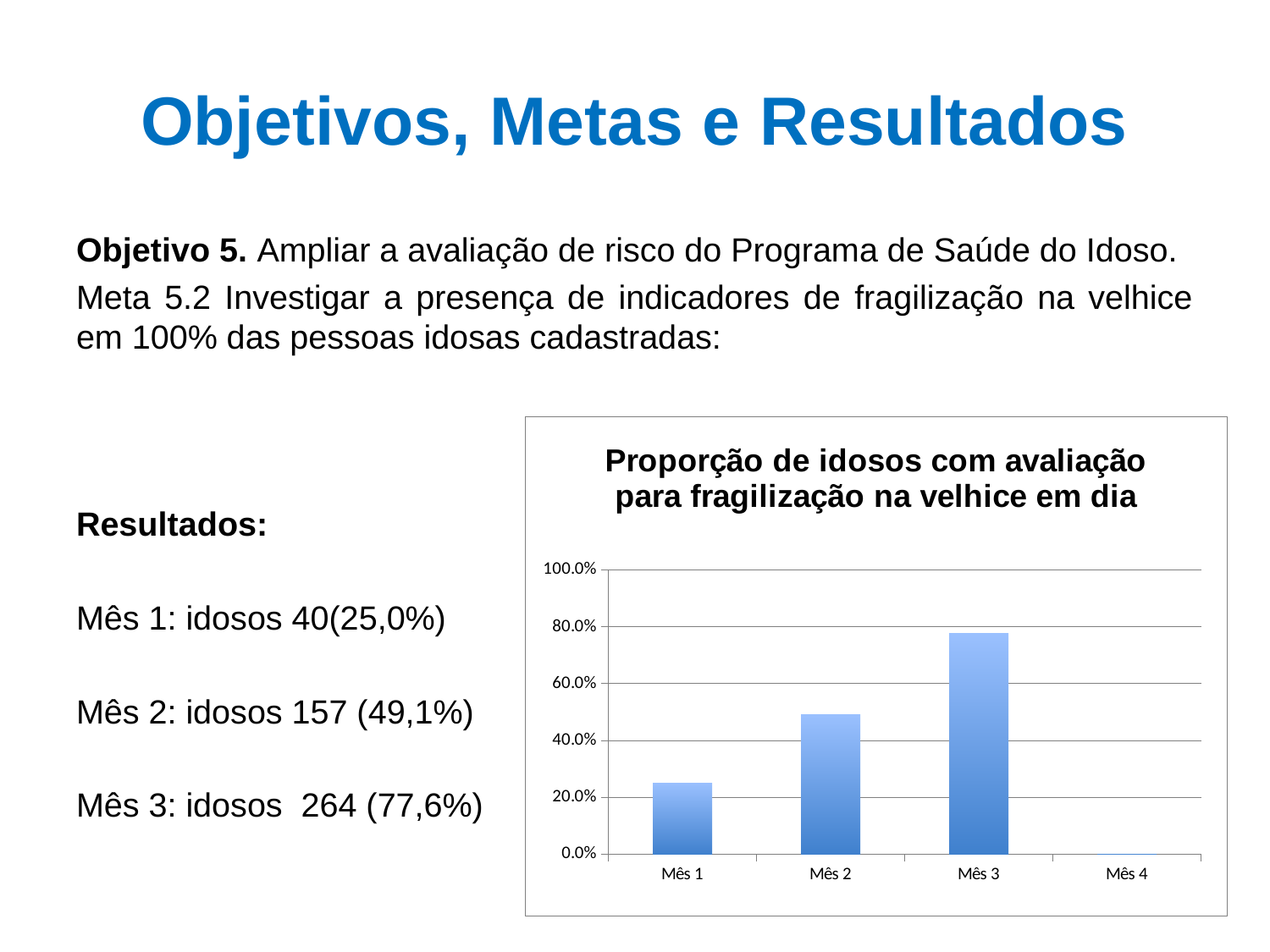
What is the title of the chart? Proporção de idosos com avaliação para fragilização na velhice em dia Is the value for Mês 3 greater or less than 60.0%? greater Which month has the highest bar in the chart? Mês 3 Which is larger, the value for Mês 2 or the value for Mês 3? Mês 3 What kind of chart is shown on the slide? bar chart Do the values rise or fall from Mês 1 to Mês 3? rise Among Mês 1, Mês 2 and Mês 3, which month has the lowest value in the chart? Mês 1 Is the value for Mês 3 greater or less than 80.0%? less How many categories are shown on the x axis of the chart? 4 Is the value for Mês 1 greater or less than 40.0%? less